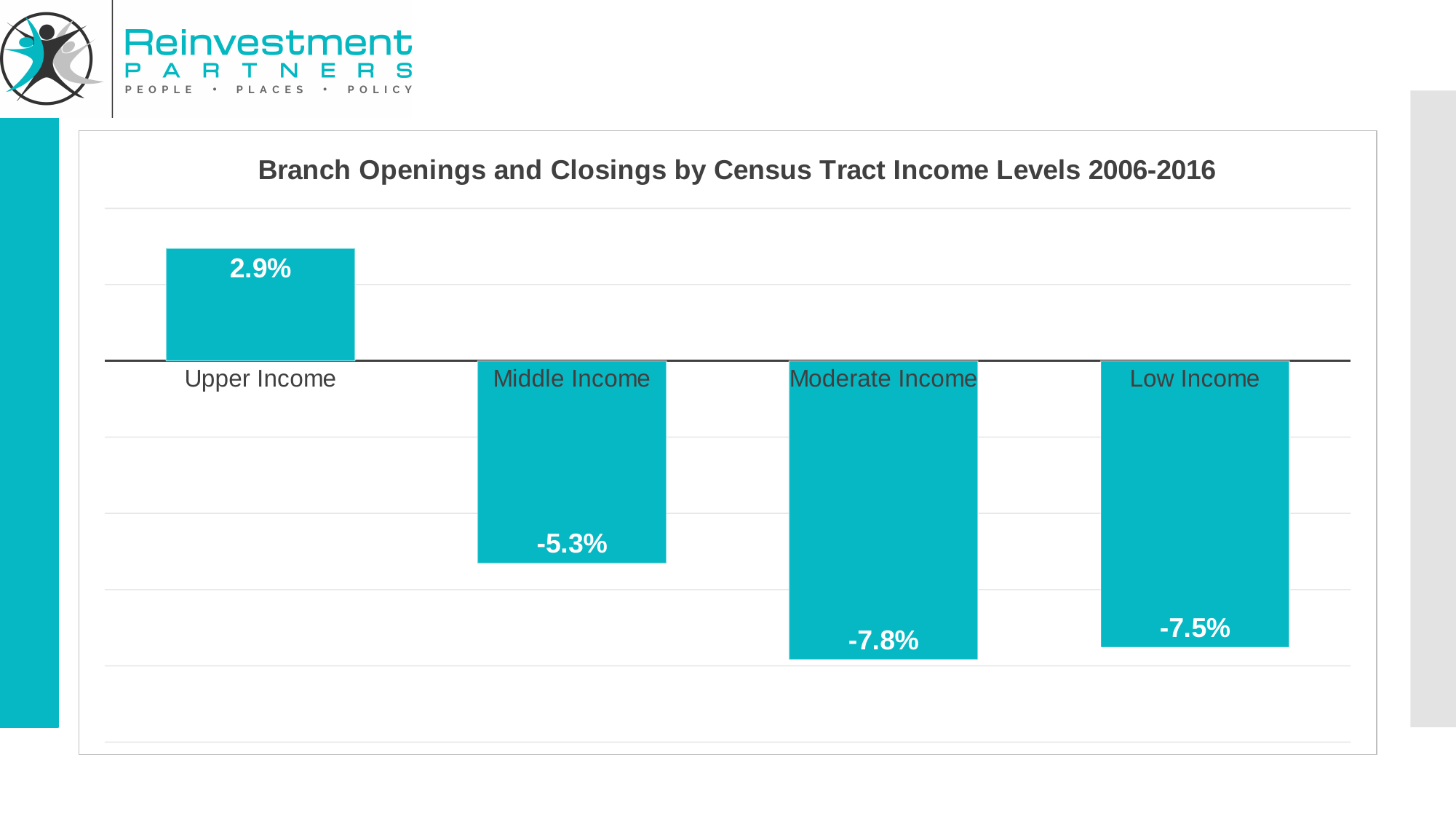
What is the difference between the values for Upper Income and Middle Income? 8.2 percentage points Which is larger, the value for Middle Income or the value for Low Income? Middle Income What kind of chart is shown on the slide? Bar chart What is the value for Upper Income? 2.9% How many income level categories are shown in the chart? 4 How many categories have a negative value? 3 Which income level has the lowest value? Moderate Income What is the value for Middle Income? -5.3% What is the value for Low Income? -7.5% What is the title of the chart? Branch Openings and Closings by Census Tract Income Levels 2006-2016 Which income level has the highest value? Upper Income What is the value for Moderate Income? -7.8%